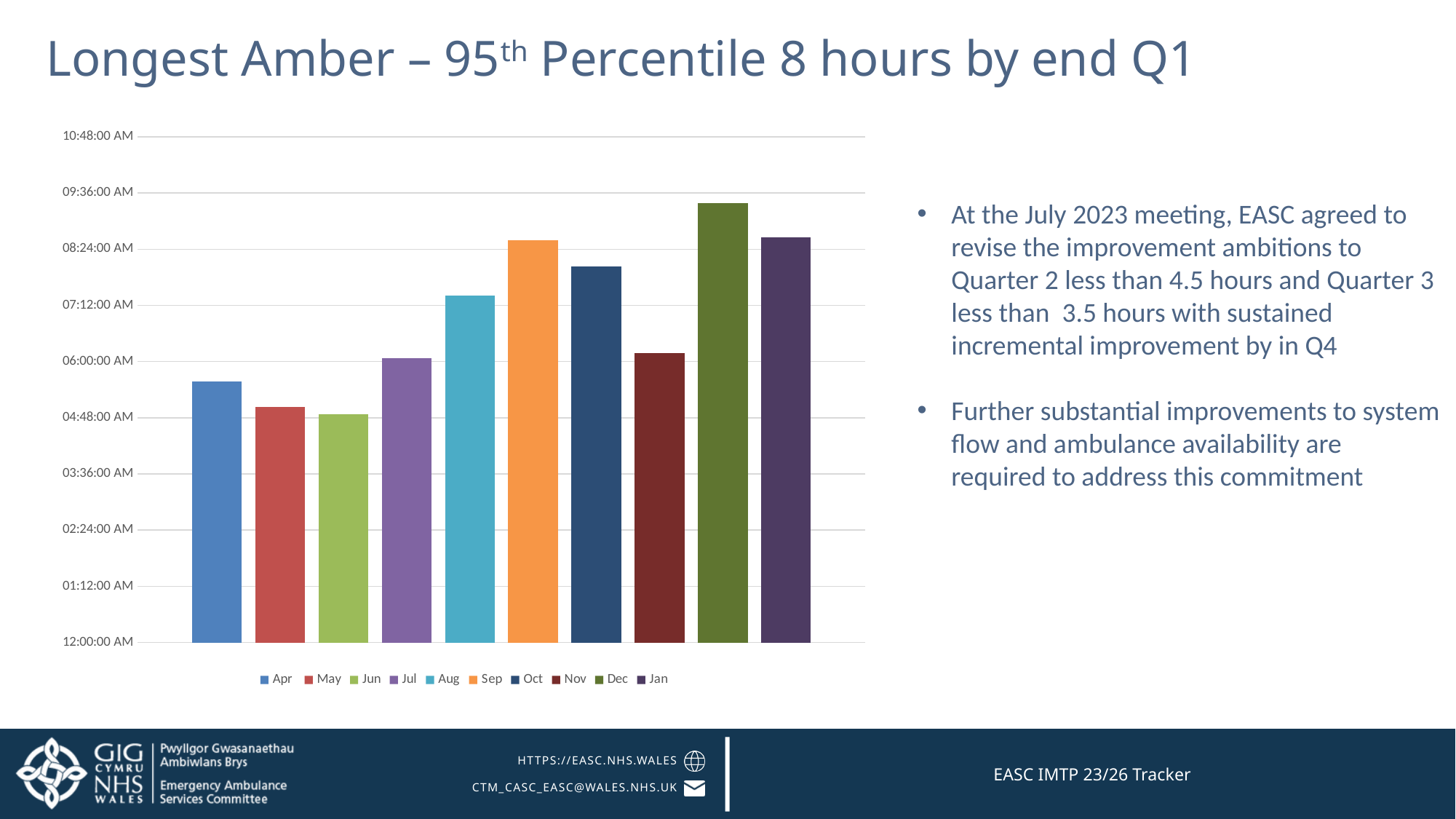
Is the value for Dec greater or less than 08:24:00 AM? greater How many bars (months) are plotted in the chart? 10 From Jun to Sep, do the bar values rise or fall? rise Which is higher, the bar for Sep or the bar for Oct? Sep Is the value for Apr greater or less than 06:00:00 AM? less Is the value for Oct greater or less than 08:24:00 AM? less Which is higher, the bar for Dec or the bar for Jan? Dec What kind of chart is shown on the slide? bar chart What is the title of the slide containing the chart? Longest Amber – 95th Percentile 8 hours by end Q1 Which month has the highest bar in the chart? Dec How many entries does the chart legend list? 10